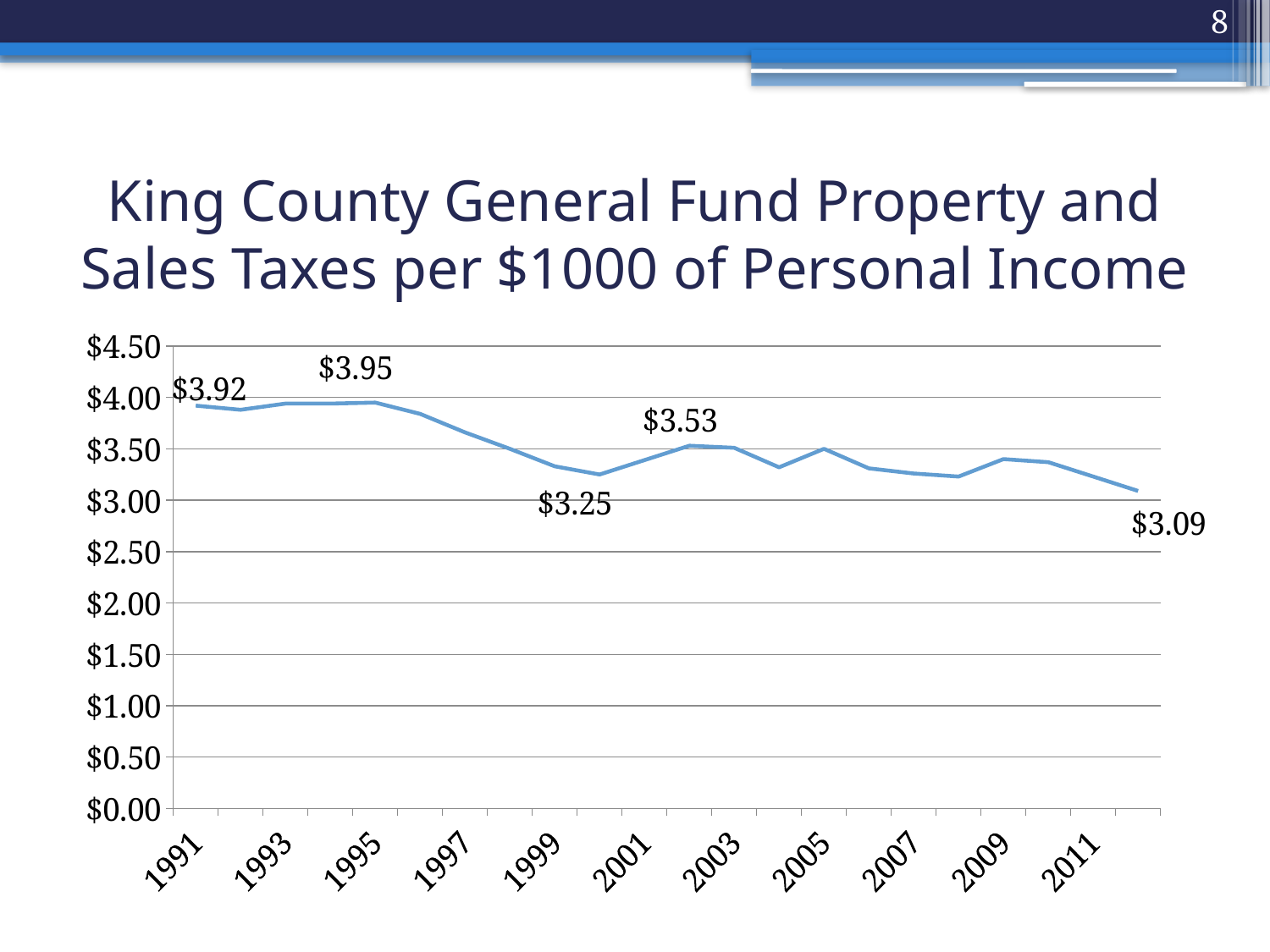
What is the highest value labeled on the chart? $3.95 What is the value labeled for 1995? $3.95 What is the value labeled at the dip between 1999 and 2001? $3.25 Is the value for 2007 greater or less than $3.50? less Which year has the larger value, 1991 or 2003? 1991 What is the value labeled for 1991? $3.92 What is the difference between the 1991 value and the last labeled value ($3.09)? $0.83 What kind of chart is shown on the slide? line chart What is the value labeled at the last data point of the line? $3.09 Overall, do the values rise or fall from 1991 to the end of the series? fall What is the lowest value labeled on the chart? $3.09